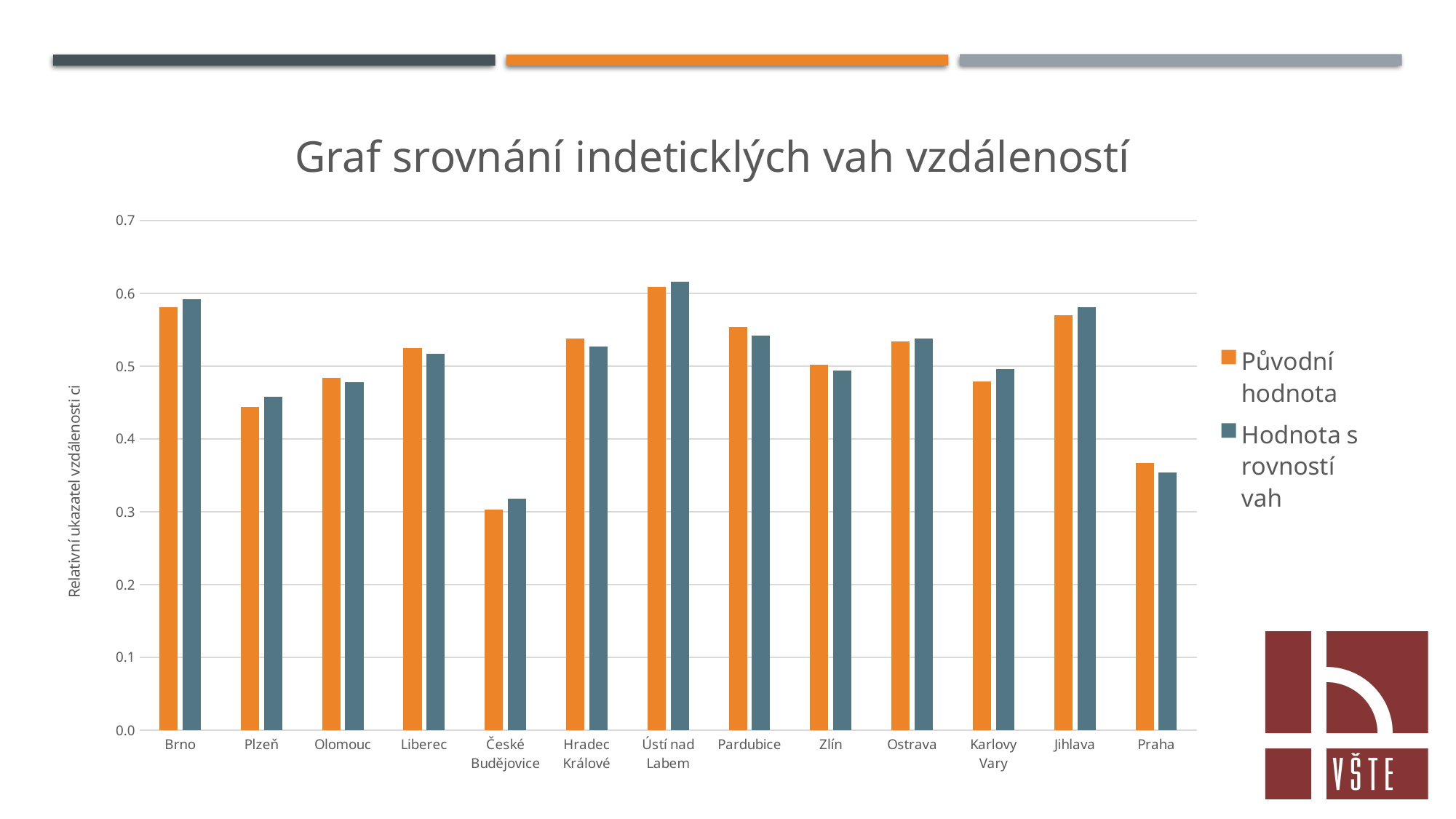
Is the Hodnota s rovností vah value for Ústí nad Labem greater or less than 0.6? greater Which is larger: the Původní hodnota value for Brno or for Praha? Brno Is the Původní hodnota value for Plzeň greater or less than 0.5? less What is the title of the chart? Graf srovnání indeticklých vah vzdáleností Which city has the highest value for Původní hodnota? Ústí nad Labem Is the Původní hodnota value for Praha greater or less than 0.4? less What colour are the bars for the series Původní hodnota? orange Which city has the lowest value for Hodnota s rovností vah? České Budějovice How many series does the legend list? 2 What kind of chart is shown on the slide? bar chart How many cities are shown on the x axis of the chart? 13